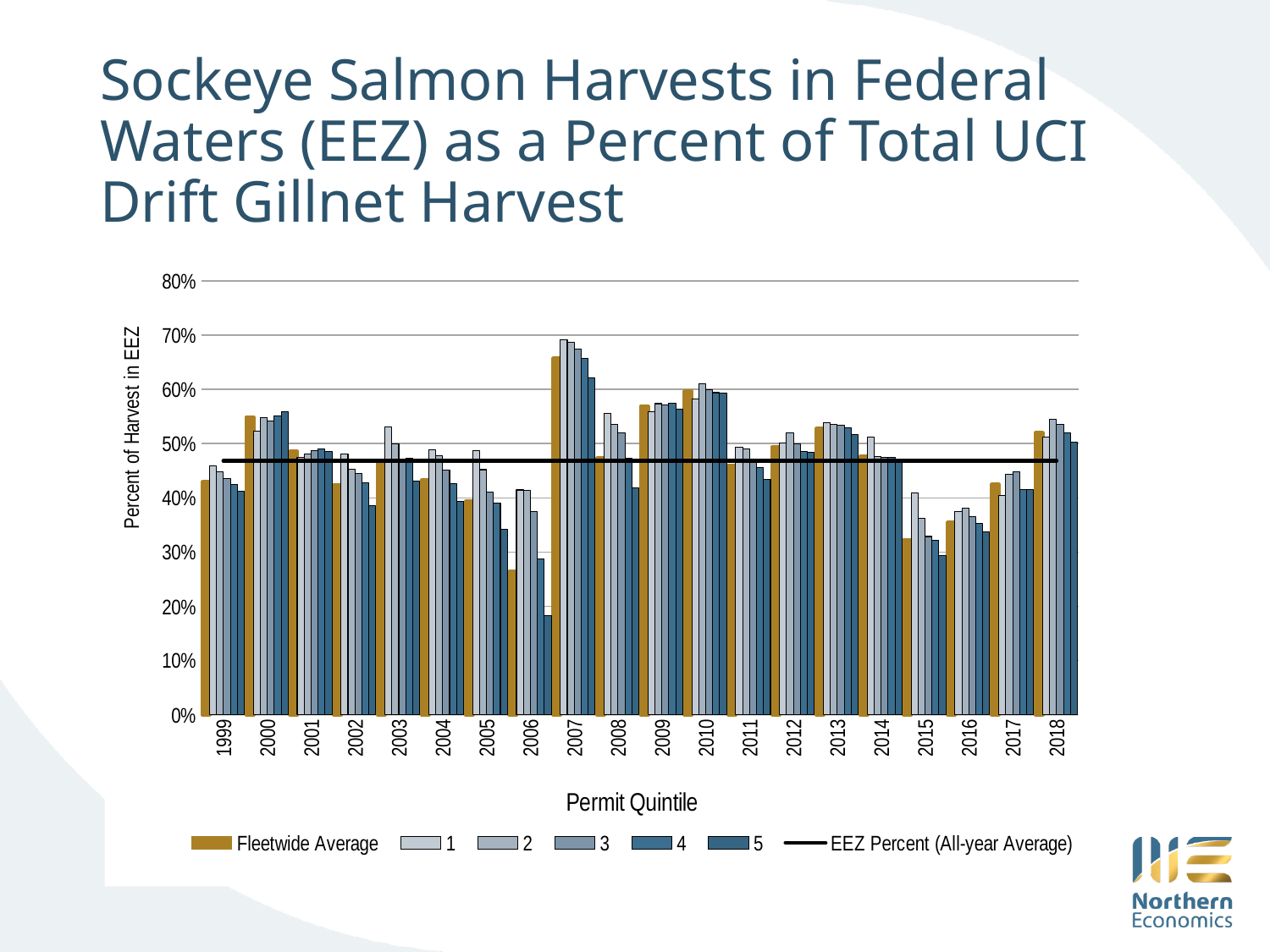
Which is larger, the Fleetwide Average for 2009 or for 2015? 2009 In which year is the Fleetwide Average bar the lowest? 2006 Is the value for quintile 5 in 2006 greater or less than 20%? less What kind of chart is shown on the slide? Combination bar and line chart Is the Fleetwide Average value for 2006 greater or less than 30%? less What is the label on the chart's vertical axis? Percent of Harvest in EEZ Is the Fleetwide Average value for 2007 greater or less than 60%? greater In which year is the Fleetwide Average bar the highest? 2007 How many entries does the chart's legend list? 7 How many years are shown along the x axis of the chart? 20 Does the Fleetwide Average rise or fall from 2015 to 2018? Rise